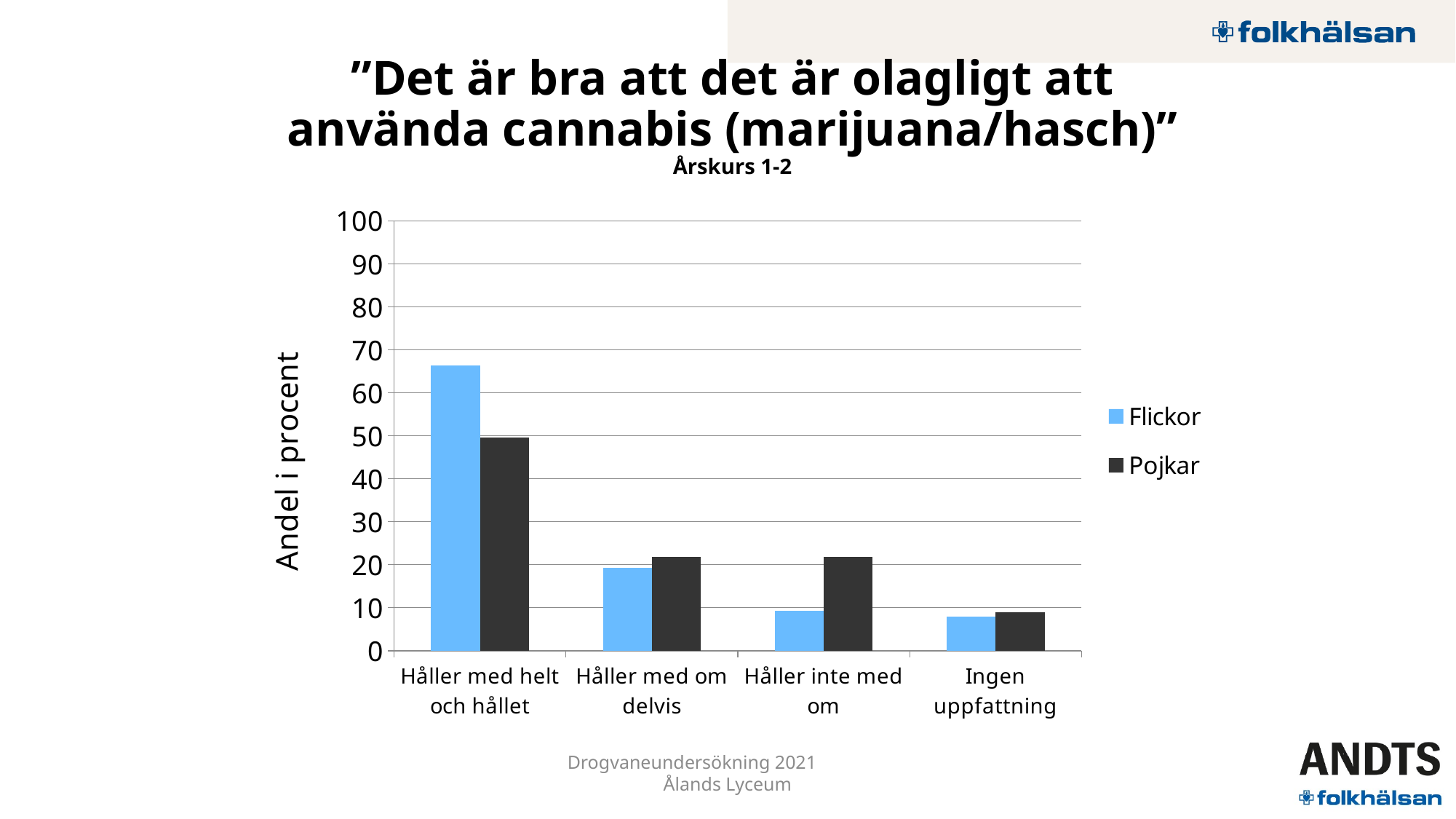
How many categories are shown on the x axis? 4 How many series does the legend list? 2 Do the Flickor values rise or fall from left to right along the x axis? Fall For 'Håller med helt och hållet', which is larger, Flickor or Pojkar? Flickor Which category has the highest value for Flickor? Håller med helt och hållet What is the title of the y axis? Andel i procent Is the value for Pojkar in 'Håller med helt och hållet' greater or less than 40? greater Is the value for Flickor in 'Ingen uppfattning' greater or less than 10? less Is the value for Flickor in 'Håller med helt och hållet' greater or less than 60? greater What kind of chart is shown on the slide? Bar chart Which category has the lowest value for Pojkar? Ingen uppfattning For 'Håller inte med om', which is larger, Flickor or Pojkar? Pojkar